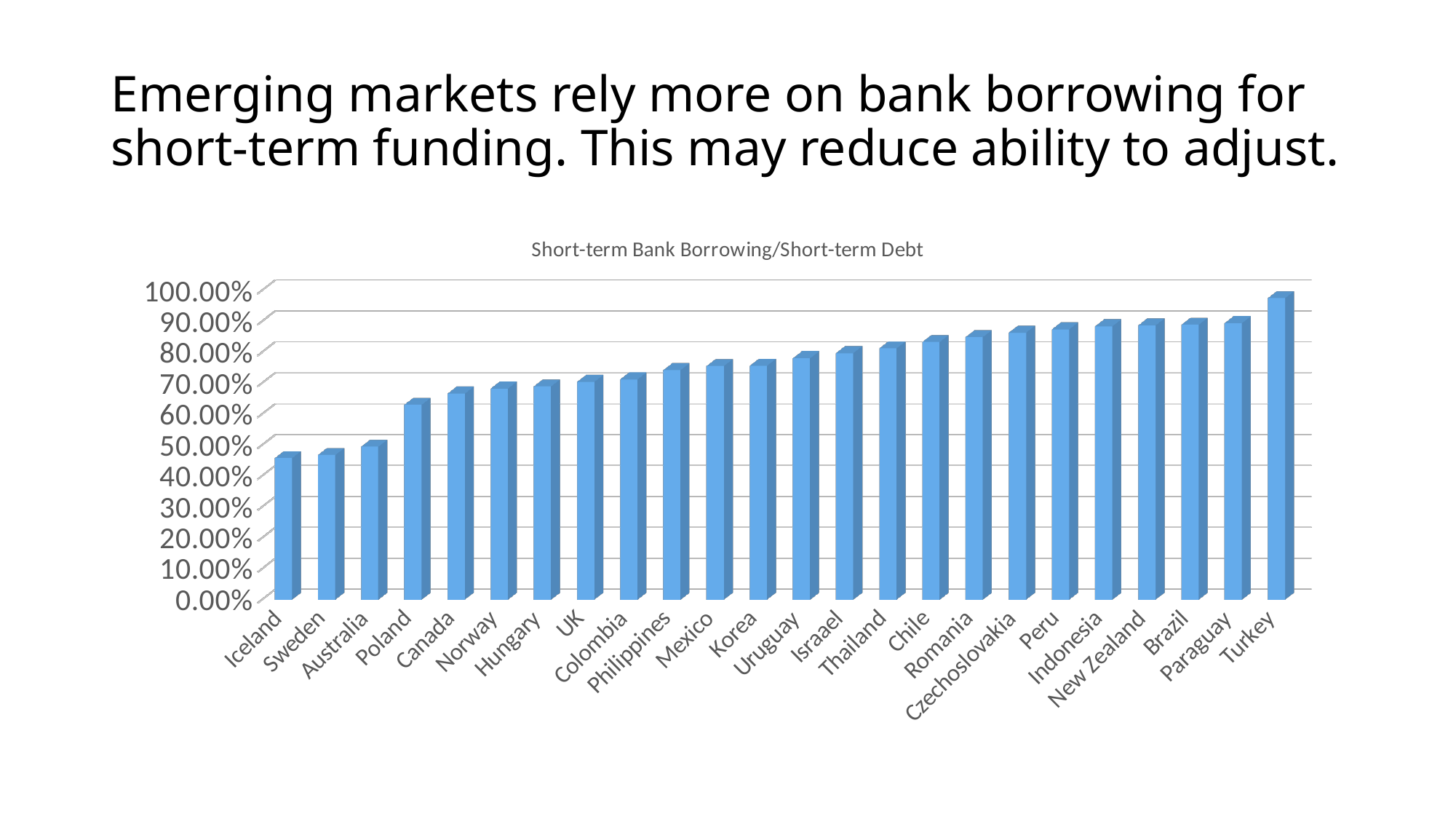
Is the value for Turkey greater or less than 90.00%? greater What kind of chart is shown on the slide? Bar chart Is the value for Poland greater or less than 60.00%? greater Which country has the highest value in the chart? Turkey Do the values generally rise or fall moving from left to right along the x axis? Rise What is the title of the chart? Short-term Bank Borrowing/Short-term Debt Is the value for Iceland greater or less than 50.00%? less Which country has the lowest value in the chart? Iceland How many countries are shown on the x axis of the chart? 24 Which has a larger value, Poland or Australia? Poland